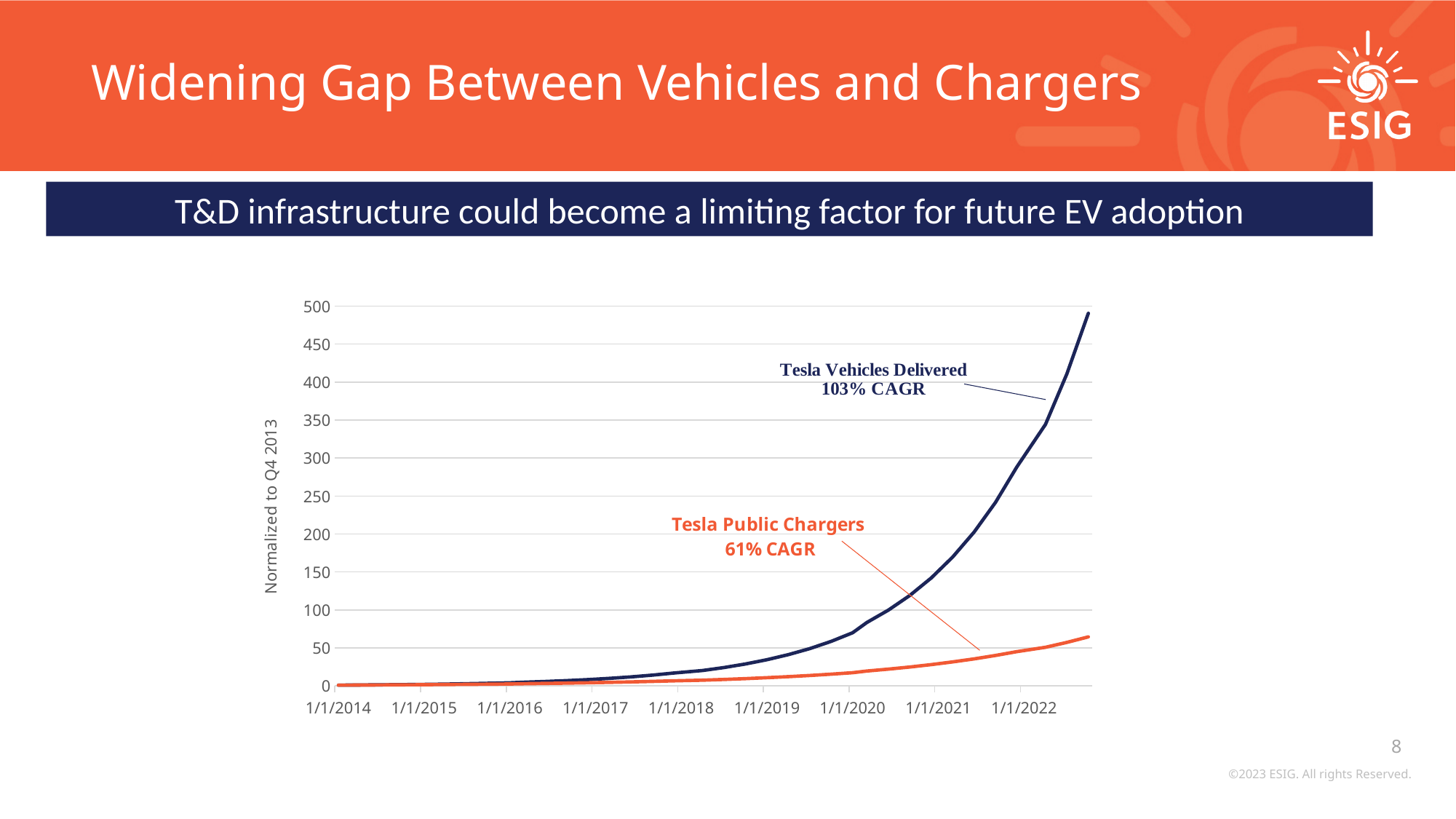
What is the label on the y axis of the chart? Normalized to Q4 2013 How many date labels are shown on the x axis? 9 Is the value for Tesla Vehicles Delivered at 1/1/2021 greater or less than 100? greater How many data series are plotted on the chart? 2 What CAGR is stated for Tesla Vehicles Delivered? 103% CAGR Do the values for Tesla Vehicles Delivered rise or fall from 1/1/2014 to the end of the chart? rise Is the value for Tesla Public Chargers at 1/1/2021 greater or less than 50? less What kind of chart is shown on the slide? line chart What CAGR is stated for Tesla Public Chargers? 61% CAGR Is the value for Tesla Vehicles Delivered at the right end of the chart greater or less than 450? greater Which series has the higher value at the right end of the chart, Tesla Vehicles Delivered or Tesla Public Chargers? Tesla Vehicles Delivered